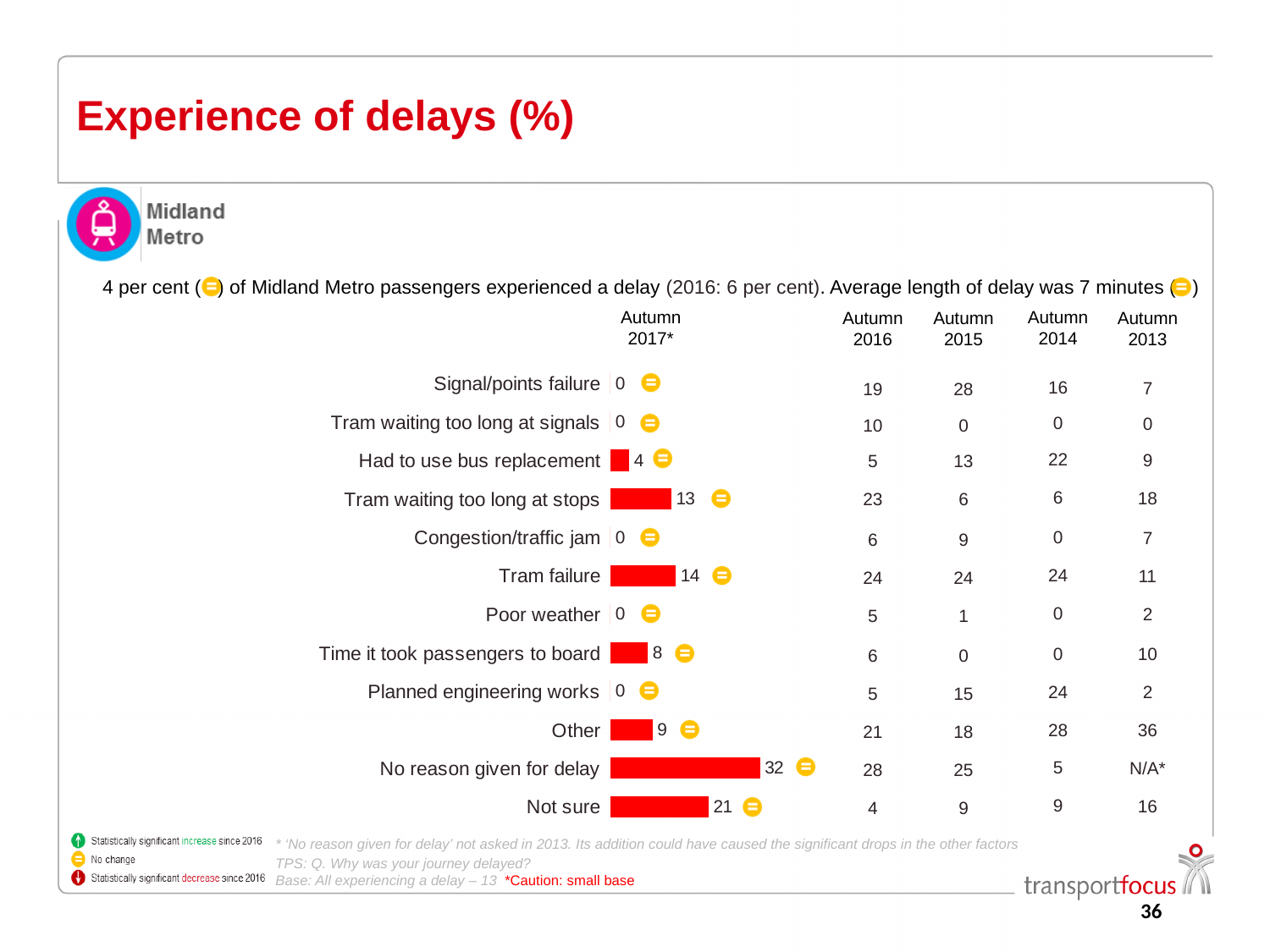
What is the Autumn 2017 value for 'Tram failure'? 14 What is the Autumn 2017 value for 'Not sure'? 21 How many delay categories are listed in the bar chart? 12 In Autumn 2017, which is larger: 'Other' or 'Had to use bus replacement'? Other What is the Autumn 2017 value for 'No reason given for delay'? 32 What is the title of the slide containing the chart? Experience of delays (%) What type of chart is used to show the Autumn 2017 values? Bar chart What is the difference between the Autumn 2017 values for 'Tram failure' and 'Tram waiting too long at stops'? 1 How many categories have an Autumn 2017 value of 0? 5 What is the difference between the Autumn 2017 values for 'No reason given for delay' and 'Not sure'? 11 What is the Autumn 2017 value for 'Time it took passengers to board'? 8 Which category has the highest Autumn 2017 value in the bar chart? No reason given for delay